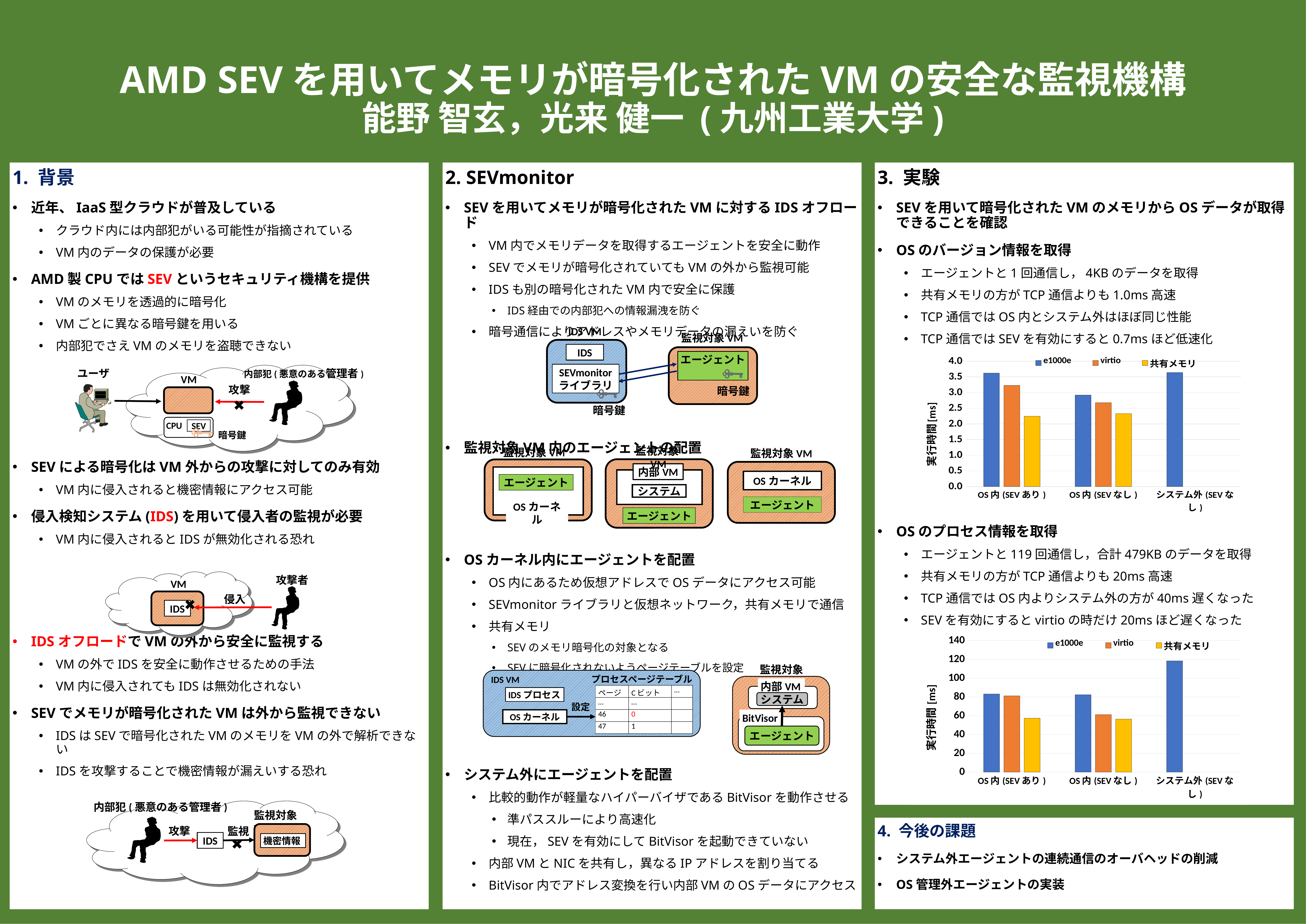
In the lower chart in section 3, is the e1000e value for システム外(SEVなし) greater or less than 100? greater How many series does the legend of the upper chart in section 3 list? 3 What is the y-axis label of the lower chart in section 3? 実行時間 [ms] What kind of chart is the upper chart in section 3 (実験)? bar chart How many categories are shown on the x axis of the lower chart in section 3? 3 In the lower chart in section 3, which category has the highest e1000e value? システム外(SEVなし) In the upper chart in section 3, is the e1000e value for OS内(SEVあり) greater or less than 3.0? greater In the upper chart in section 3, is the 共有メモリ value for OS内(SEVあり) greater or less than 2.5? less In the upper chart in section 3, which is larger for OS内(SEVあり): the e1000e value or the 共有メモリ value? e1000e What are the legend entries of the lower chart in section 3? e1000e, virtio, 共有メモリ In the upper chart in section 3, which series has the lowest value for OS内(SEVなし)? 共有メモリ